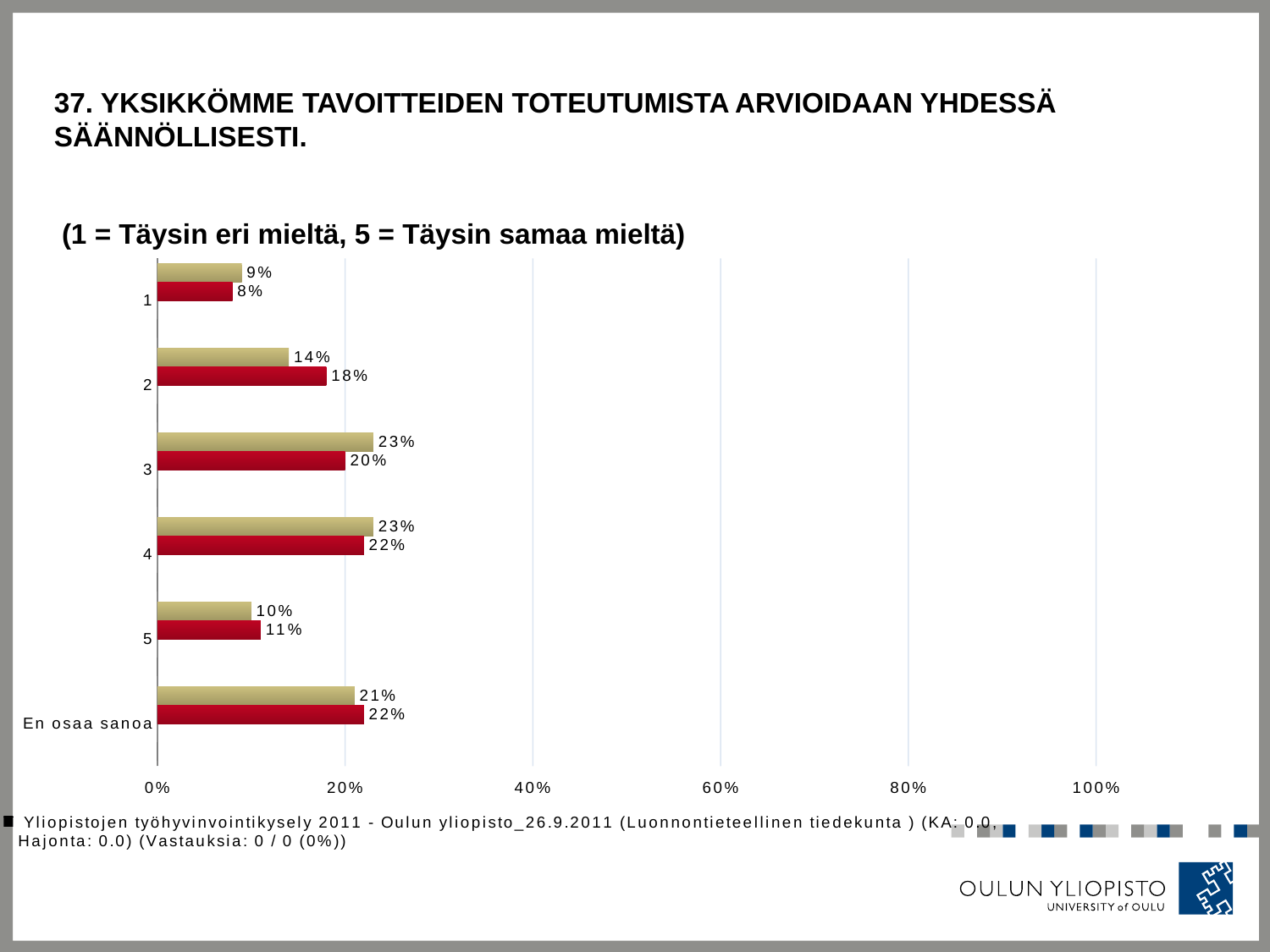
For category 2, which bar is larger, the tan bar or the red bar? the red bar Which category has the lowest value for the red bars? 1 What is the value of the red bar for category 2? 18% What is the value of the red bar for the category 'En osaa sanoa'? 22% Is the value of the red bar for category 4 greater or less than 40%? less What is the value of the tan (upper) bar for category 3? 23% What is the difference between the red bar and the tan bar for category 2? 4 percentage points How many categories are shown on the vertical axis of the chart? 6 What is the highest value shown on the horizontal axis of the chart? 100% Which category has the lowest value for the tan (upper) bars? 1 What type of chart is shown on the slide? bar chart What is the value of the tan (upper) bar for category 5? 10%